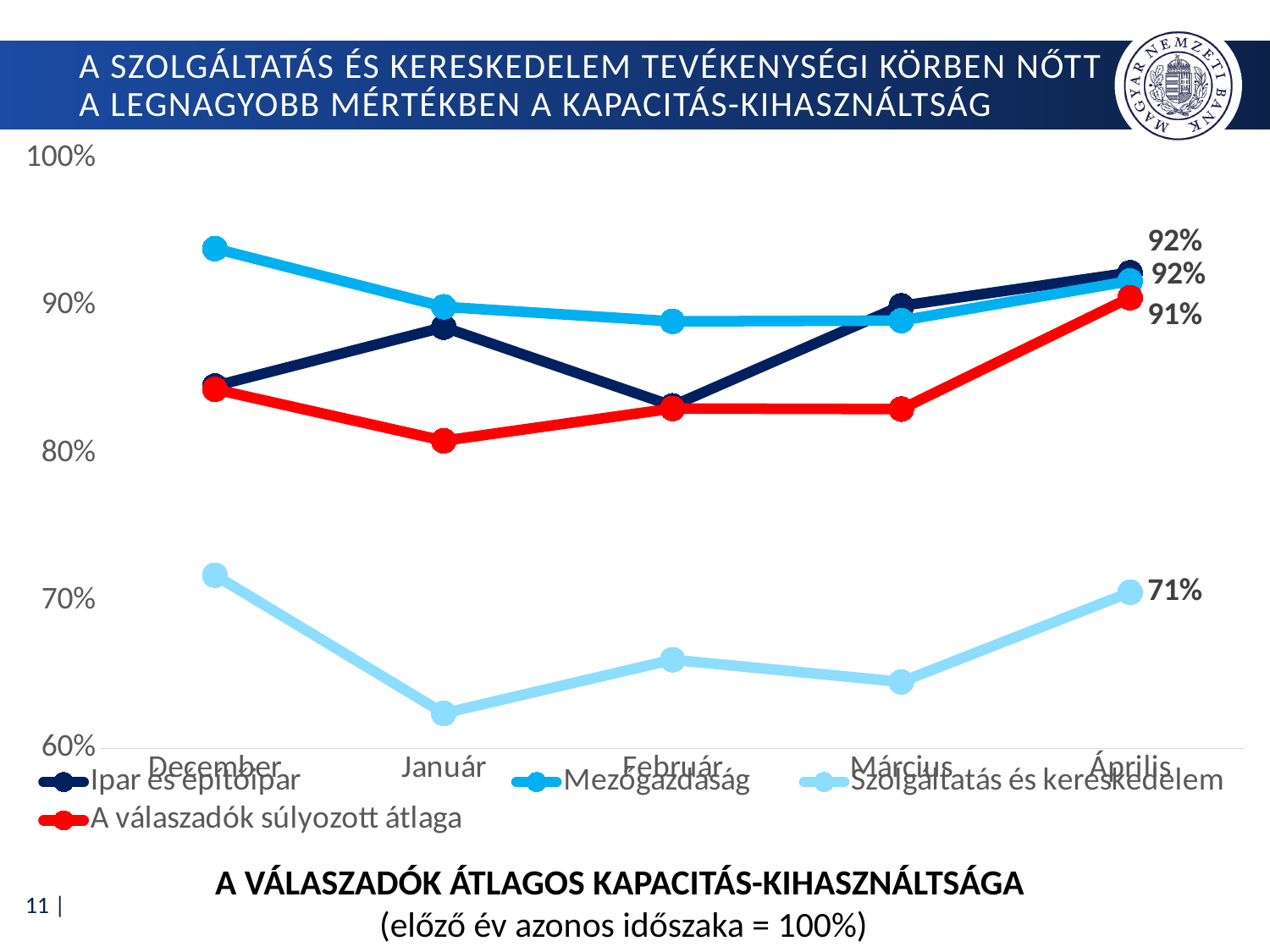
How many series does the legend list? 4 Does the value for Szolgáltatás és kereskedelem rise or fall from Március to Április? rise Which series has the lowest value in Április? Szolgáltatás és kereskedelem What kind of chart is shown on the slide? line chart What is the value for Szolgáltatás és kereskedelem in Április? 71% How many months are shown on the x axis? 5 What is the value for Ipar és építőipar in Április? 92% Is the value for Szolgáltatás és kereskedelem in Január greater or less than 70%? less In December, which is larger: the value for Mezőgazdaság or the value for Ipar és építőipar? Mezőgazdaság What is the value for A válaszadók súlyozott átlaga in Április? 91% Is the value for Mezőgazdaság in December greater or less than 90%? greater What is the difference between the Április values of Ipar és építőipar and Szolgáltatás és kereskedelem? 21 percentage points